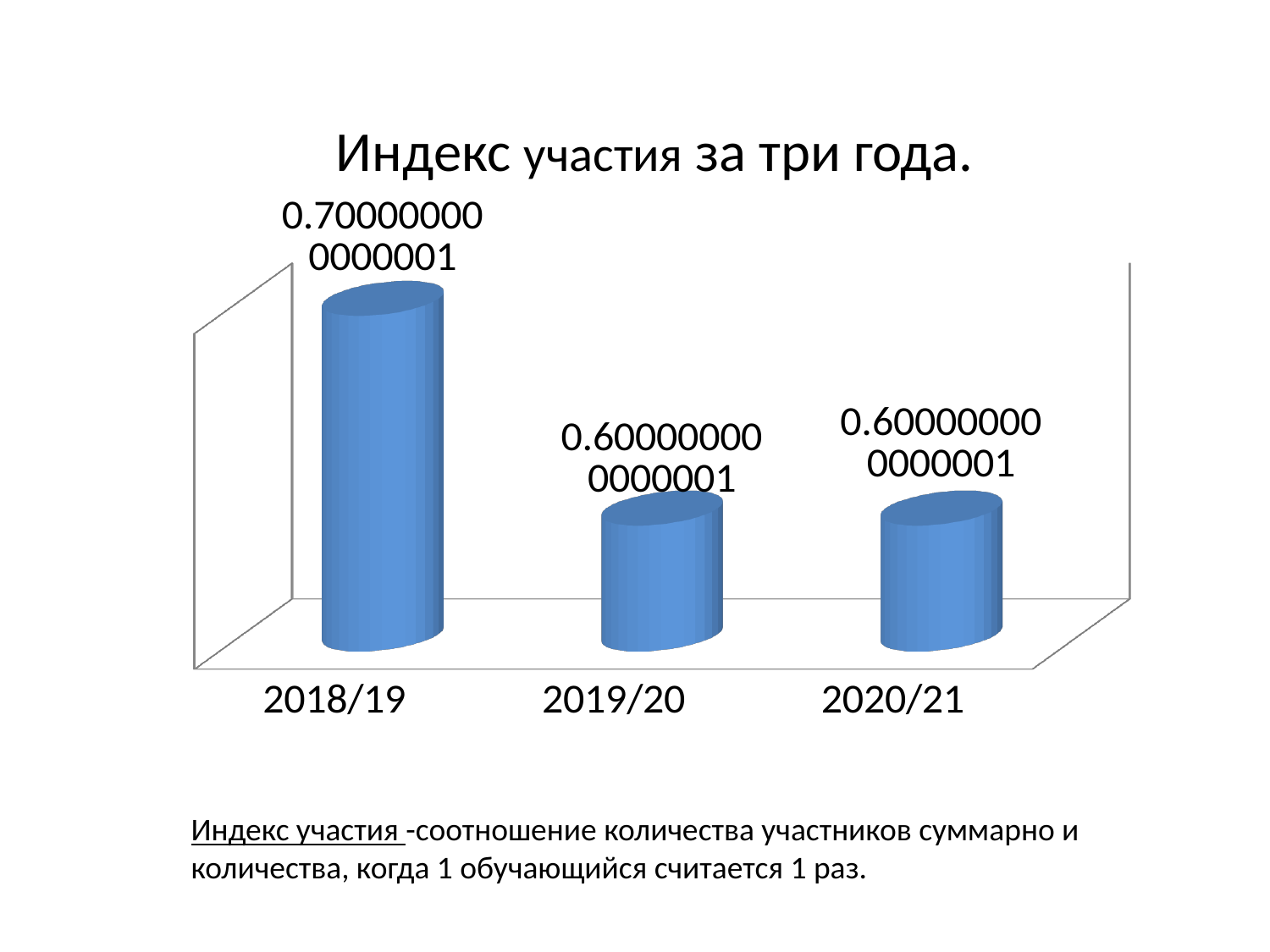
Does the value rise or fall from 2018/19 to 2019/20? Fall What is the title of the chart? Индекс участия за три года. What is the value for 2018/19? 0.700000000000001 Which is larger, the value for 2018/19 or the value for 2019/20? 2018/19 What is the value for 2019/20? 0.600000000000001 What is the difference between the values for 2018/19 and 2020/21? 0.1 What is the difference between the values for 2018/19 and 2019/20? 0.1 How many categories are shown on the x axis? 3 What is the value for 2020/21? 0.600000000000001 What colour are the bars in the chart? Blue What kind of chart is this? Bar chart Which year has the highest value? 2018/19